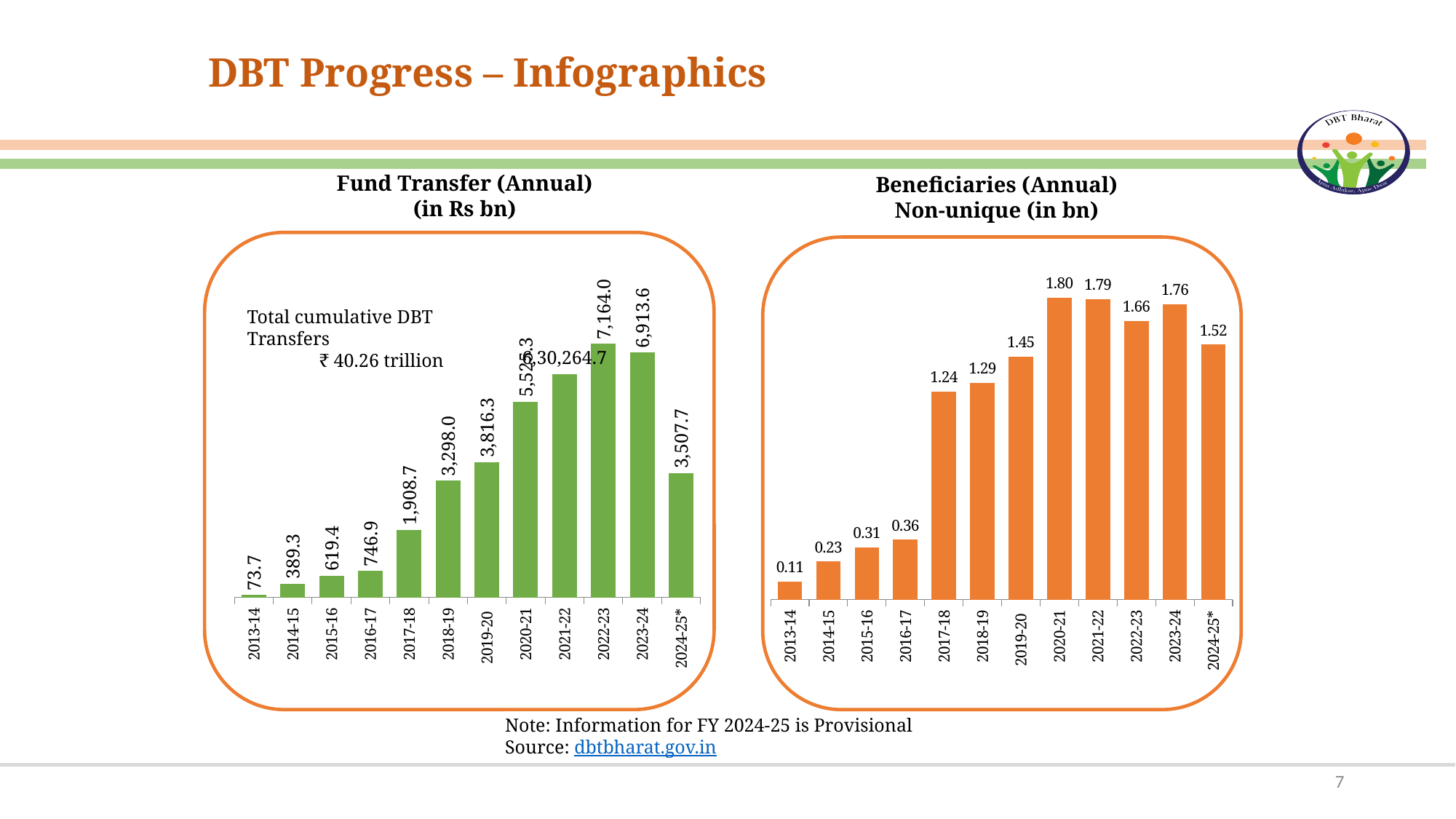
In the Fund Transfer (Annual) chart, how many years are plotted? 12 In the Fund Transfer (Annual) chart, what is the difference between the 2018-19 and 2017-18 values? 1,389.3 What kind of chart is the Beneficiaries (Annual) chart? Bar chart In the Fund Transfer (Annual) chart, which year has the highest value? 2022-23 In the Beneficiaries (Annual) chart, which year has the lowest value? 2013-14 In the Beneficiaries (Annual) chart, which is larger, the value for 2017-18 or 2016-17? 2017-18 According to the text in the Fund Transfer (Annual) chart, what is the total cumulative DBT transfer amount? ₹ 40.26 trillion In the Beneficiaries (Annual) chart, which year has the highest value? 2020-21 In the Beneficiaries (Annual) chart, what is the difference between the 2023-24 and 2022-23 values? 0.10 In the Beneficiaries (Annual) chart, what is the value for 2019-20? 1.45 In the Fund Transfer (Annual) chart, what is the value for 2013-14? 73.7 In the Fund Transfer (Annual) chart, what is the value for 2023-24? 6,913.6